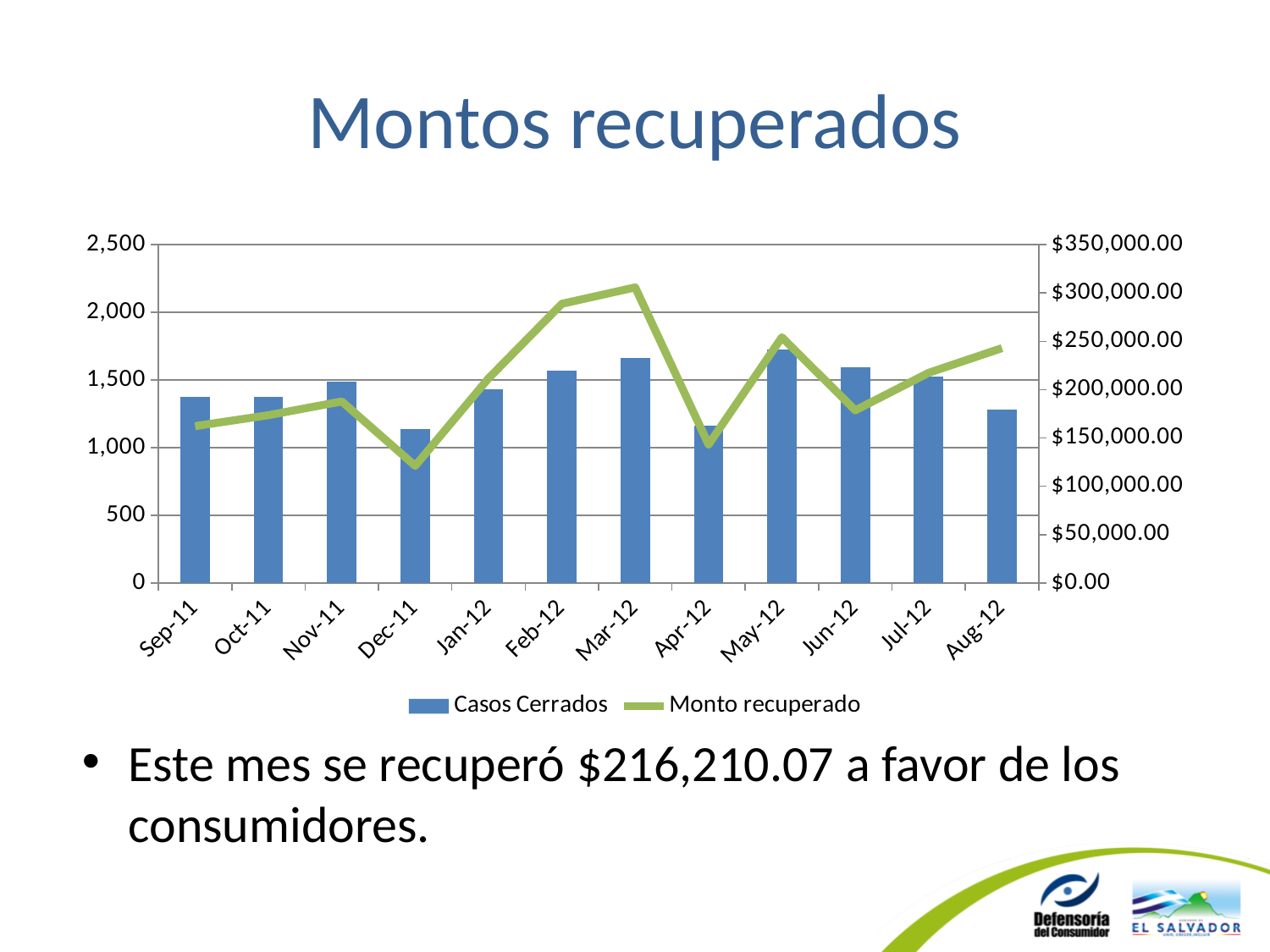
How many months are plotted along the x axis? 12 Is the Casos Cerrados value for Dec-11 greater or less than 1,500? less What is the title of the chart? Montos recuperados Which series is drawn as a line? Monto recuperado In which month does the Monto recuperado line reach its lowest point? Dec-11 Which is larger, the Casos Cerrados bar for Mar-12 or for Apr-12? Mar-12 How many series does the legend list? 2 Is the Monto recuperado value for Feb-12 greater or less than $250,000.00? greater What kind of chart is shown on the slide? Combined bar and line chart Does the Monto recuperado line rise or fall from Mar-12 to Apr-12? fall Which month has the tallest Casos Cerrados bar? May-12 In which month does the Monto recuperado line reach its highest point? Mar-12